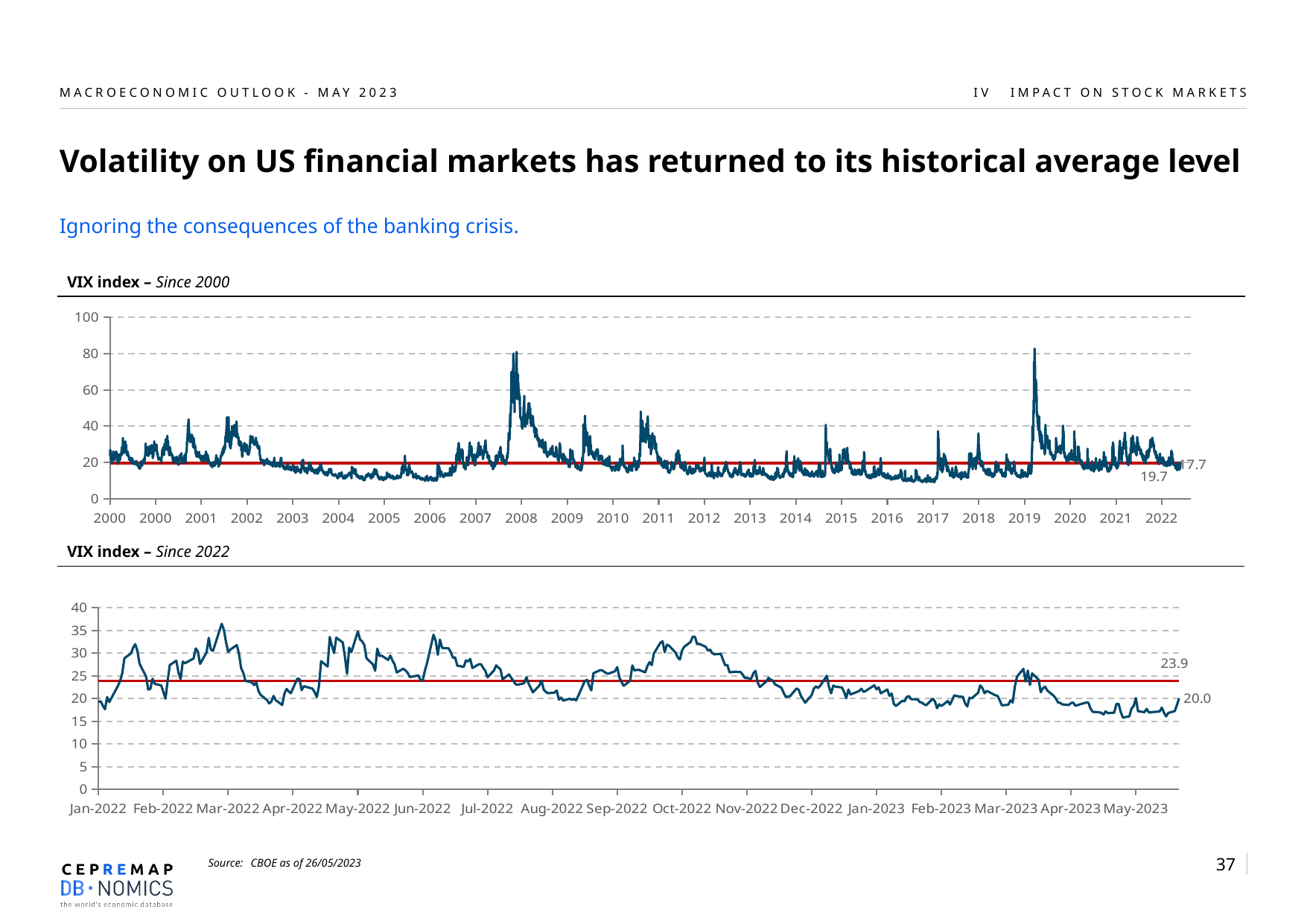
In the "VIX index – Since 2022" chart, what is the difference between the red line value (23.9) and the last labelled value (20.0)? 3.9 In the "VIX index – Since 2000" chart, is the peak of the VIX around 2008 greater or less than 60? greater In the "VIX index – Since 2022" chart, what value is labelled on the red horizontal line? 23.9 In the "VIX index – Since 2000" chart, what is the last labelled value of the VIX series? 17.7 In the "VIX index – Since 2022" chart, which is larger: the red line value or the last labelled value of the series? the red line value (23.9) What is the title of the lower chart on the slide? VIX index – Since 2022 In the "VIX index – Since 2022" chart, is the VIX value around Apr-2023 greater or less than 20? less In the "VIX index – Since 2000" chart, what is the difference between the red line value (19.7) and the last labelled value (17.7)? 2.0 In the "VIX index – Since 2022" chart, is the peak of the VIX around Oct-2022 greater or less than 30? greater In the "VIX index – Since 2000" chart, what value is labelled on the red horizontal line? 19.7 In the "VIX index – Since 2022" chart, what is the last labelled value of the VIX series? 20.0 What kind of chart is the "VIX index – Since 2000" chart? line chart